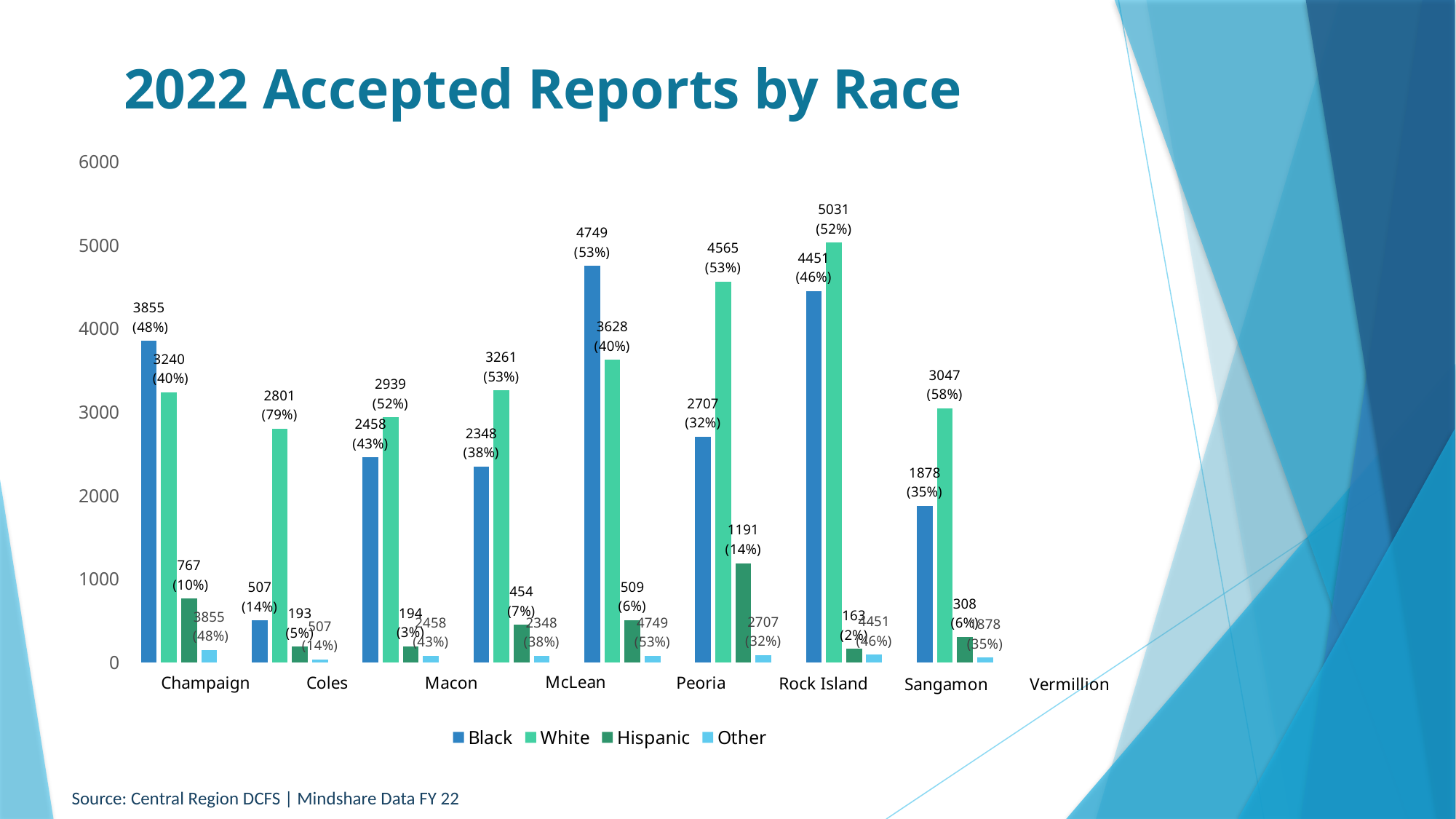
Is the value for Other in Champaign greater or less than 1000? less How many counties are shown on the x axis? 8 Which county has the highest value for White? Rock Island In Peoria, which is larger, the Black value or the White value? White How many series does the legend list? 4 What is the value for Hispanic in Rock Island? 163 Which county has the lowest value for Hispanic? Rock Island What percentage is shown for White in Coles? 79% What kind of chart is shown on the slide? Bar chart Which county has the highest value for Black? McLean What is the value for White in Coles? 2801 What is the difference between the White and Black values in Sangamon? 1169